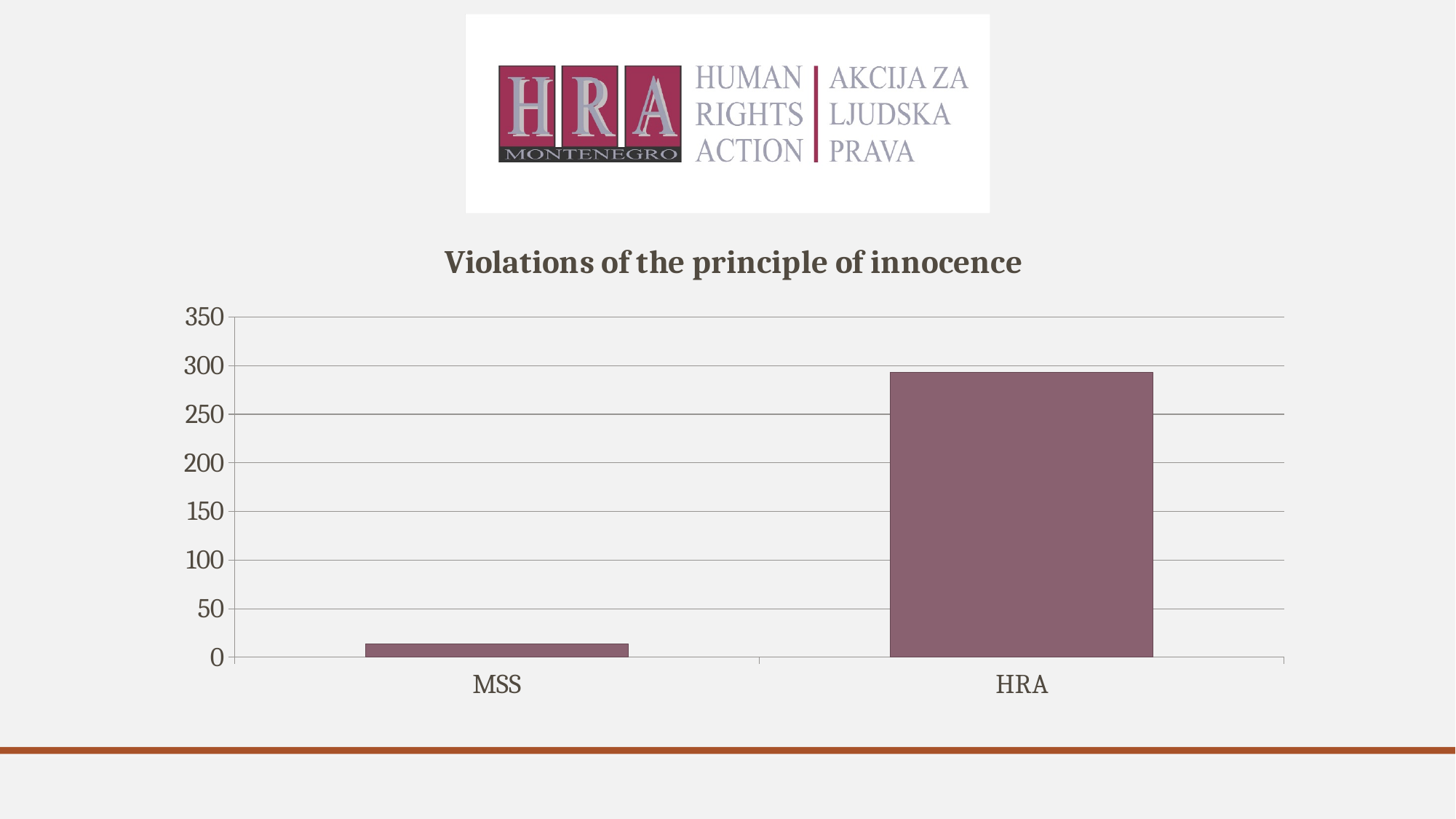
Which category has the highest value? HRA Which category has the lowest value? MSS What kind of chart is shown on the slide? bar chart Is the value for MSS greater or less than 50? less How many categories are shown on the x axis? 2 Do the values rise or fall from MSS to HRA along the x axis? rise Is the value for HRA greater or less than 300? less What is the title of the chart? Violations of the principle of innocence Which is larger, the value for MSS or the value for HRA? HRA Is the value for HRA greater or less than 250? greater What is the highest value shown on the y axis? 350